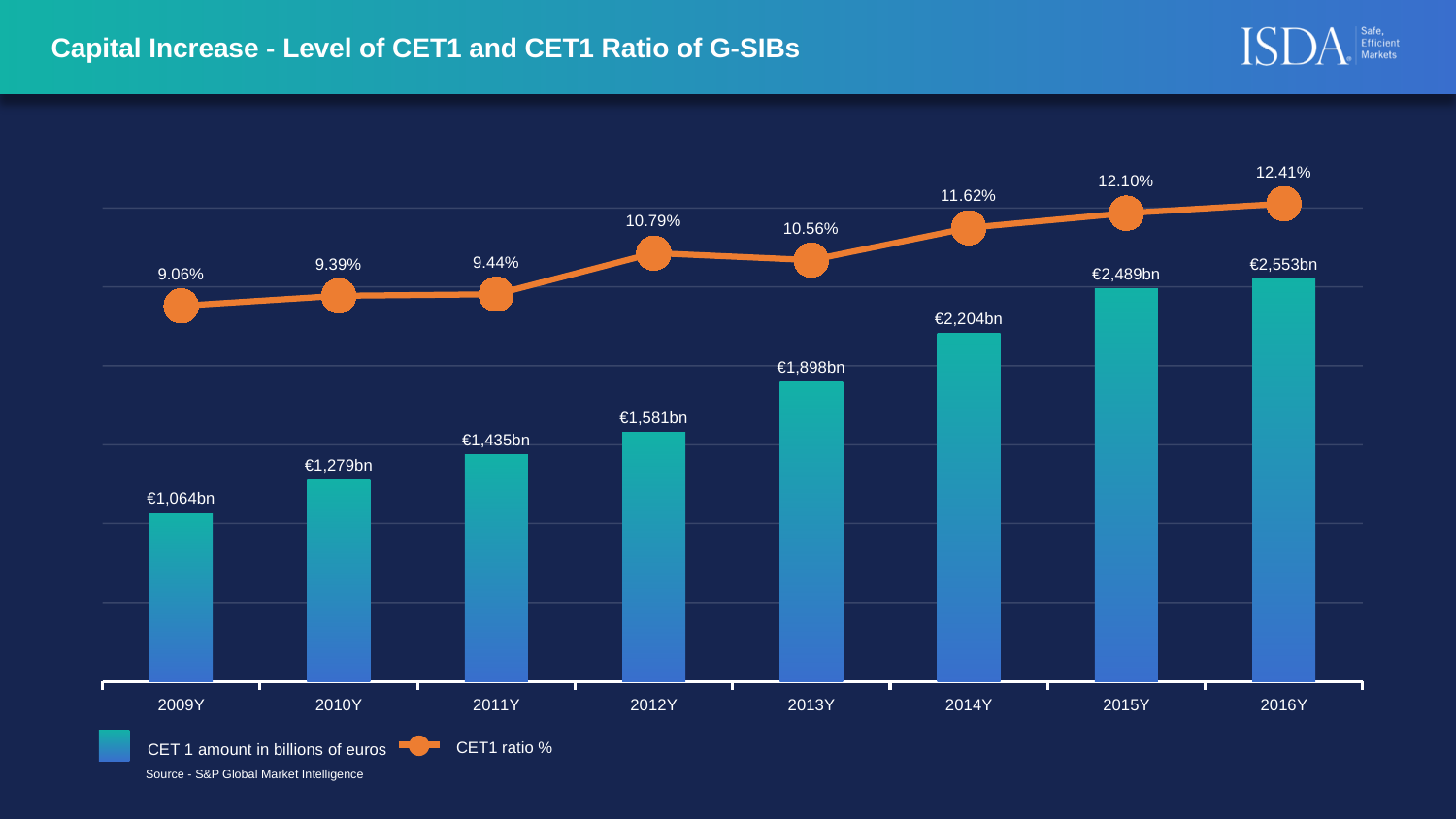
What is the source cited below the chart? S&P Global Market Intelligence How many series does the legend list? 2 How many years are shown on the x axis? 8 What is the difference in CET 1 amount between 2016Y and 2015Y? €64bn What is the CET 1 amount for 2009Y? €1,064bn What is the CET1 ratio % for 2012Y? 10.79% Does the CET 1 amount rise or fall from 2009Y to 2016Y? Rise What kind of chart is shown on the slide? Combined bar and line chart Which year has the highest CET 1 amount? 2016Y Which is larger, the CET1 ratio % for 2012Y or for 2013Y? 2012Y What is the CET 1 amount for 2014Y? €2,204bn Which year has the lowest CET1 ratio %? 2009Y